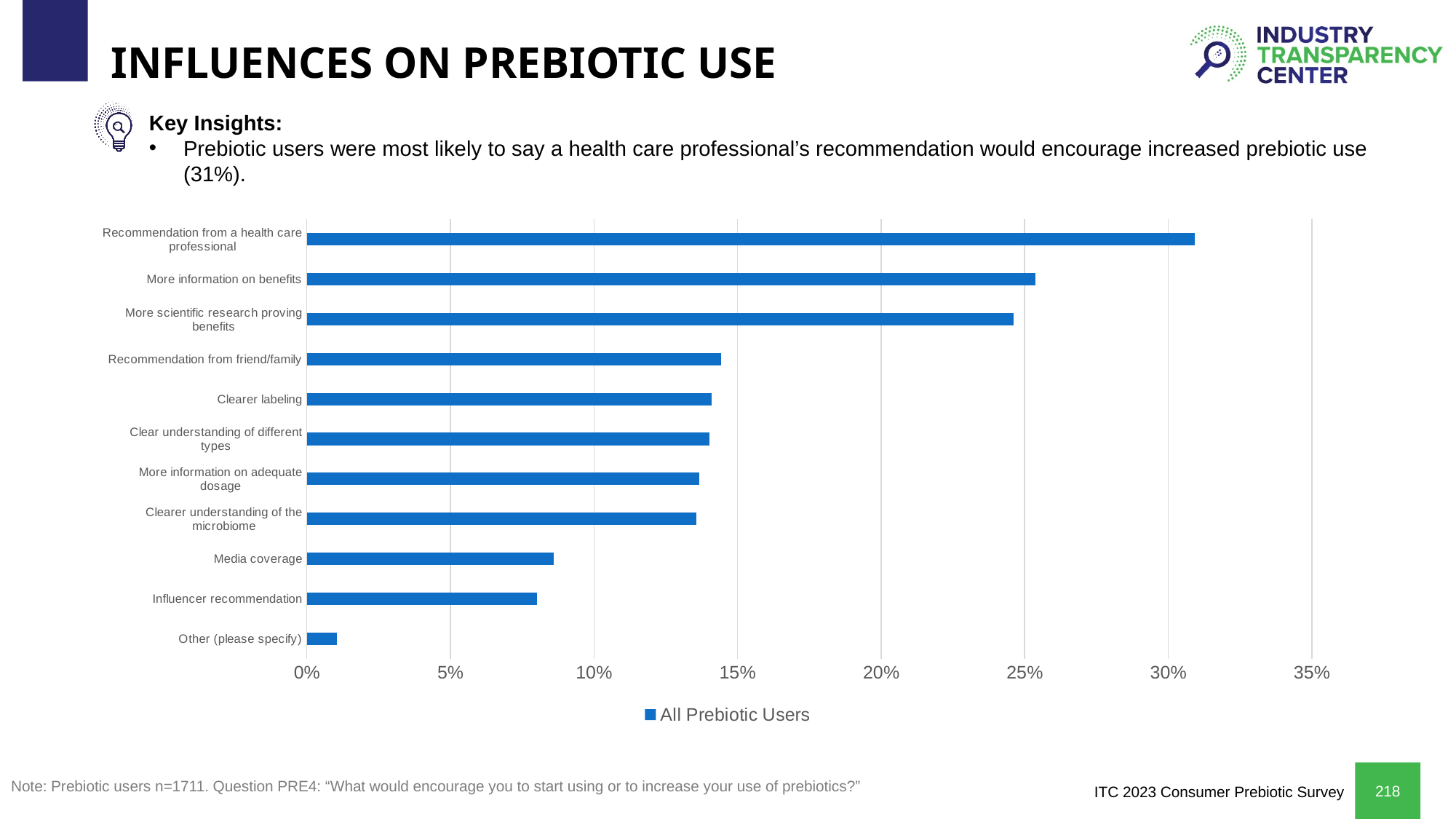
What series name is shown in the chart legend? All Prebiotic Users Which category has the highest value? Recommendation from a health care professional Which is larger, the value for More information on benefits or the value for Clearer labeling? More information on benefits How many categories are plotted on the chart? 11 Which category has the lowest value? Other (please specify) Is the value for Recommendation from a health care professional greater or less than 30%? greater How many series does the legend list? 1 Which is larger, the value for Recommendation from friend/family or the value for Media coverage? Recommendation from friend/family Is the value for Other (please specify) greater or less than 5%? less Is the value for Clearer understanding of the microbiome greater or less than 10%? greater What kind of chart is shown on the slide? bar chart